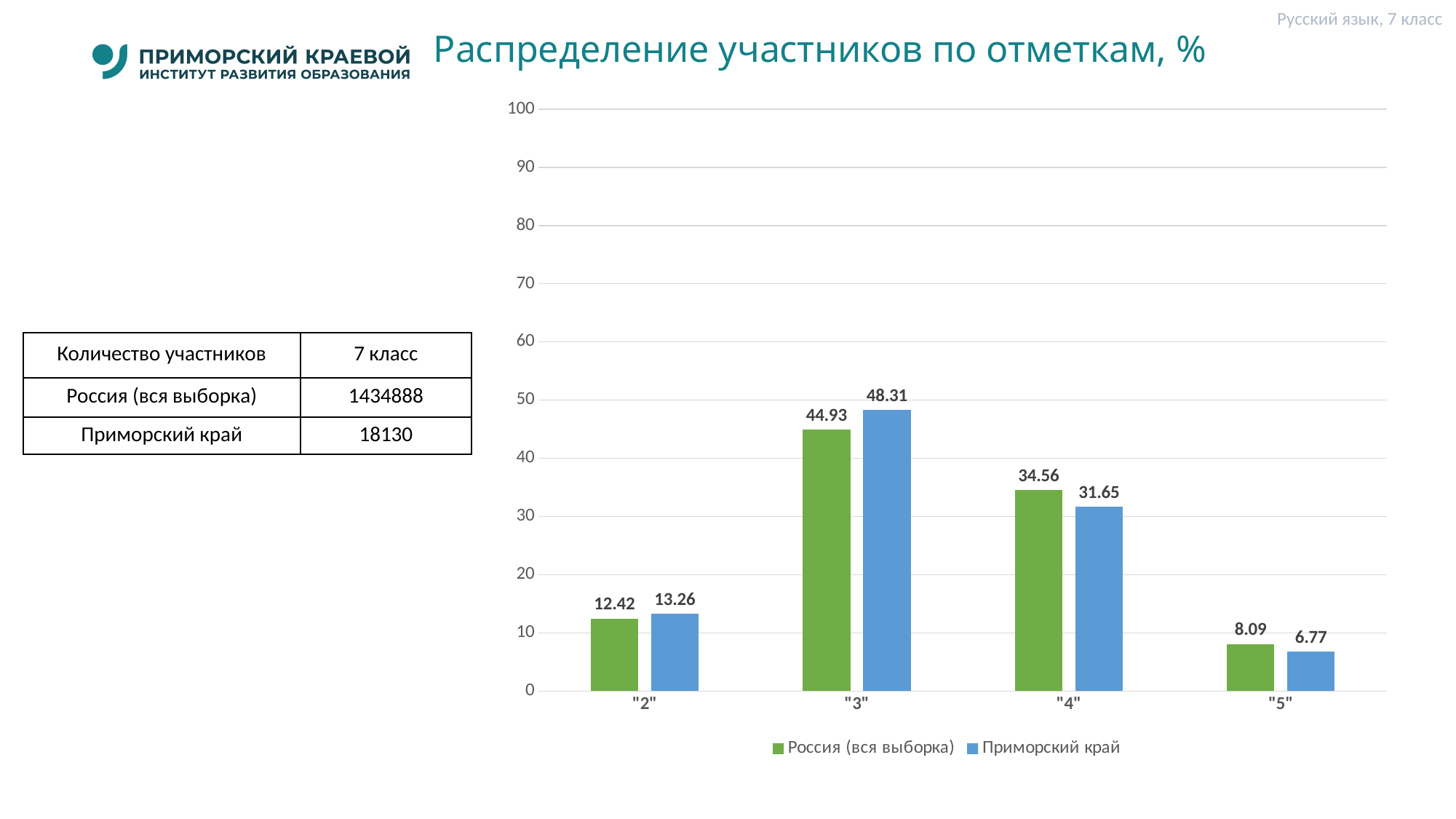
What is the value for Приморский край for mark "5"? 6.77 What is the title of the chart? Распределение участников по отметкам, % What is the difference between Приморский край and Россия (вся выборка) for mark "3"? 3.38 How many mark categories are shown on the x axis? 4 Which mark has the highest value for Россия (вся выборка)? "3" What kind of chart is shown on the slide? bar chart How many series does the legend list? 2 Which mark has the lowest value for Приморский край? "5" Is the value for Приморский край for mark "2" greater or less than 20? less Which is larger for mark "4": Россия (вся выборка) or Приморский край? Россия (вся выборка) What is the value for Россия (вся выборка) for mark "4"? 34.56 What is the value for Приморский край for mark "3"? 48.31